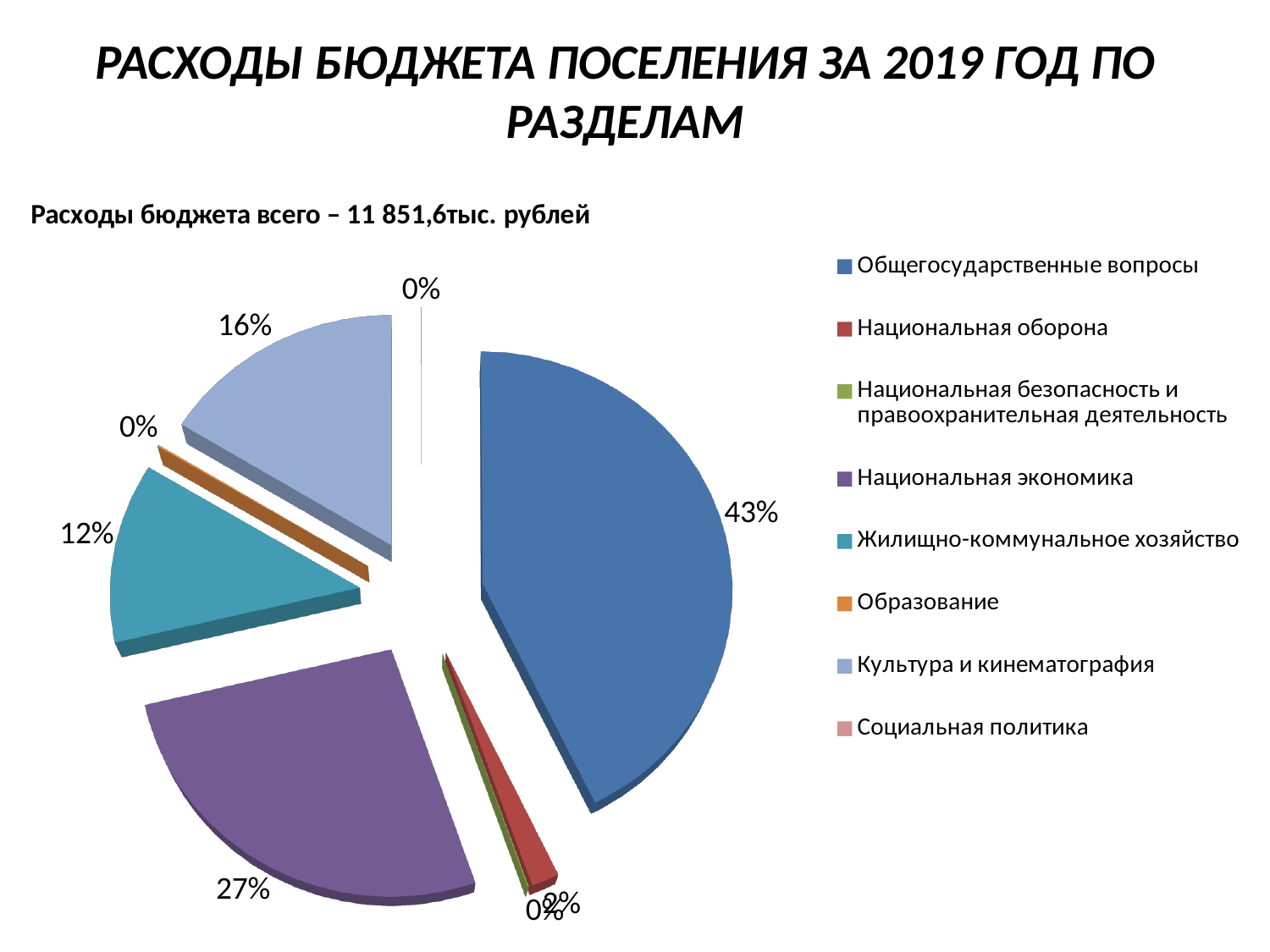
What total budget expenditure is stated above the chart? 11 851,6тыс. рублей What is the difference in percentage points between the Общегосударственные вопросы slice and the Национальная экономика slice? 16 What share of the pie does Национальная экономика have? 27% What colour is the slice for Жилищно-коммунальное хозяйство? teal What share of the pie does Образование have? 0% What share of the pie does Культура и кинематография have? 16% Which is larger: the slice for Национальная экономика or the slice for Культура и кинематография? Национальная экономика What kind of chart is shown on the slide? pie chart How many categories does the legend of the pie chart list? 8 Which category has the largest slice of the pie? Общегосударственные вопросы